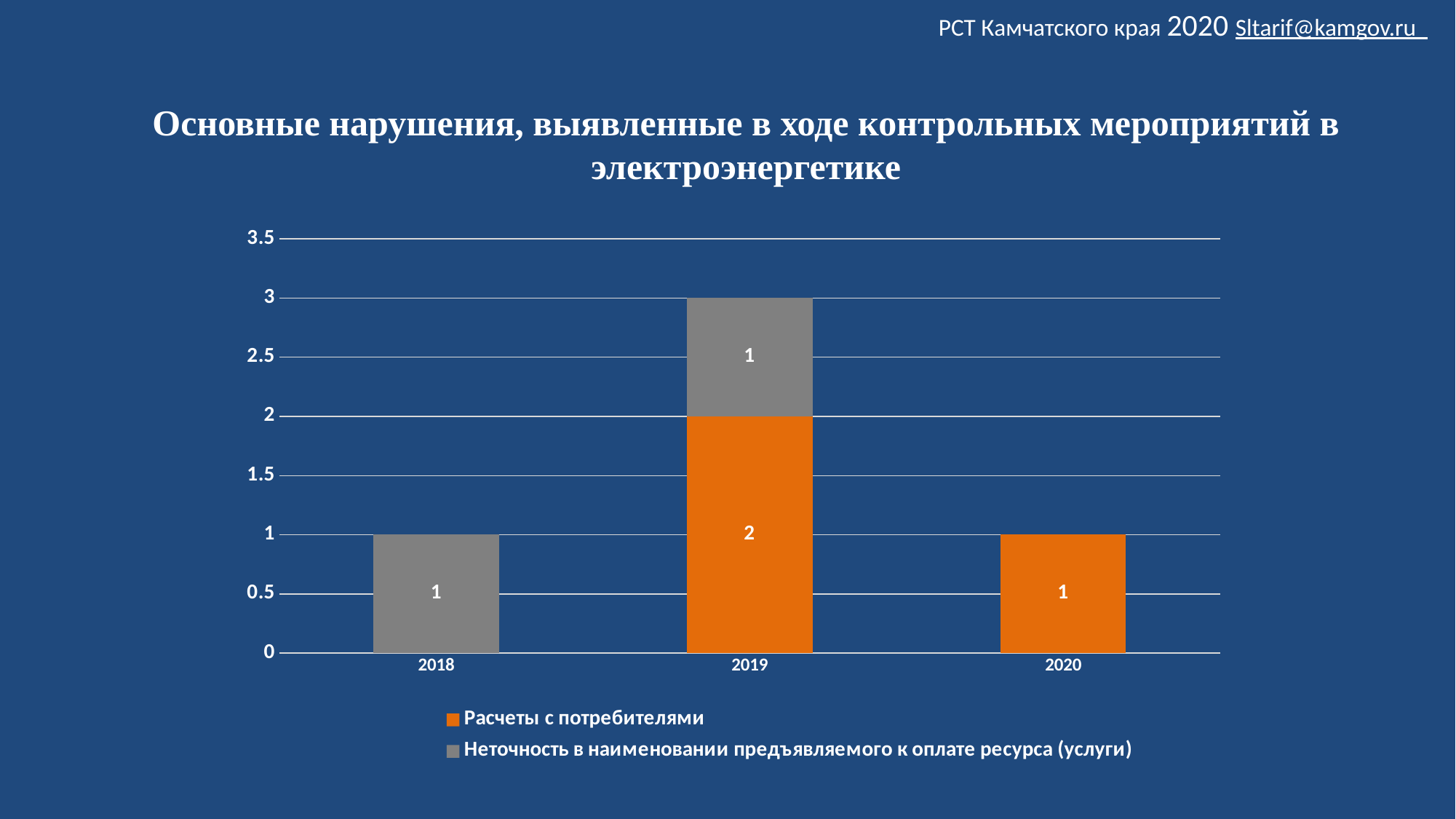
How many series does the legend list? 2 What is the total height of the stacked bar for 2019? 3 What is the value for "Неточность в наименовании предъявляемого к оплате ресурса (услуги)" in 2018? 1 Which colour represents "Расчеты с потребителями" in the chart? Orange What kind of chart is shown on the slide? Stacked bar chart Which year has the highest total of violations? 2019 What is the value for "Расчеты с потребителями" in 2020? 1 What is the difference between the "Расчеты с потребителями" values for 2019 and 2020? 1 What is the value for "Расчеты с потребителями" in 2019? 2 Which is larger: the "Расчеты с потребителями" value in 2019 or the "Неточность в наименовании предъявляемого к оплате ресурса (услуги)" value in 2019? Расчеты с потребителями What is the value for "Неточность в наименовании предъявляемого к оплате ресурса (услуги)" in 2019? 1 How many years are shown on the x axis? 3